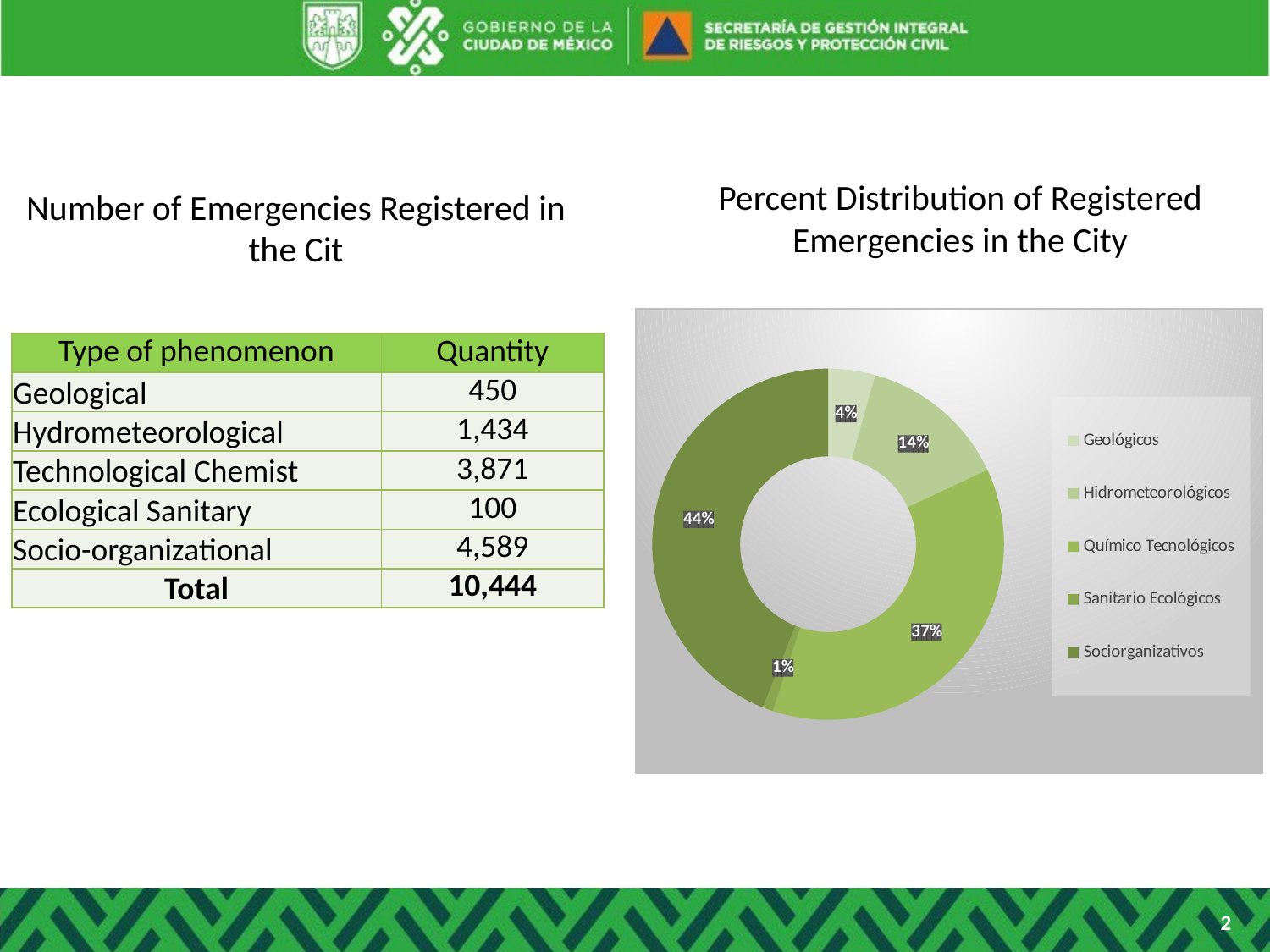
What is the difference in percentage points between Sociorganizativos and Químico Tecnológicos in the chart? 7 What percentage of the chart does Químico Tecnológicos represent? 37% Which category has the smallest share in the chart? Sanitario Ecológicos What percentage of the chart does Sociorganizativos represent? 44% What percentage of the chart does Geológicos represent? 4% What kind of chart is shown on the slide? Doughnut chart Which has a larger share in the chart, Hidrometeorológicos or Geológicos? Hidrometeorológicos What is the title of the chart on the slide? Percent Distribution of Registered Emergencies in the City Which category has the largest share in the chart? Sociorganizativos How many categories does the chart's legend list? 5